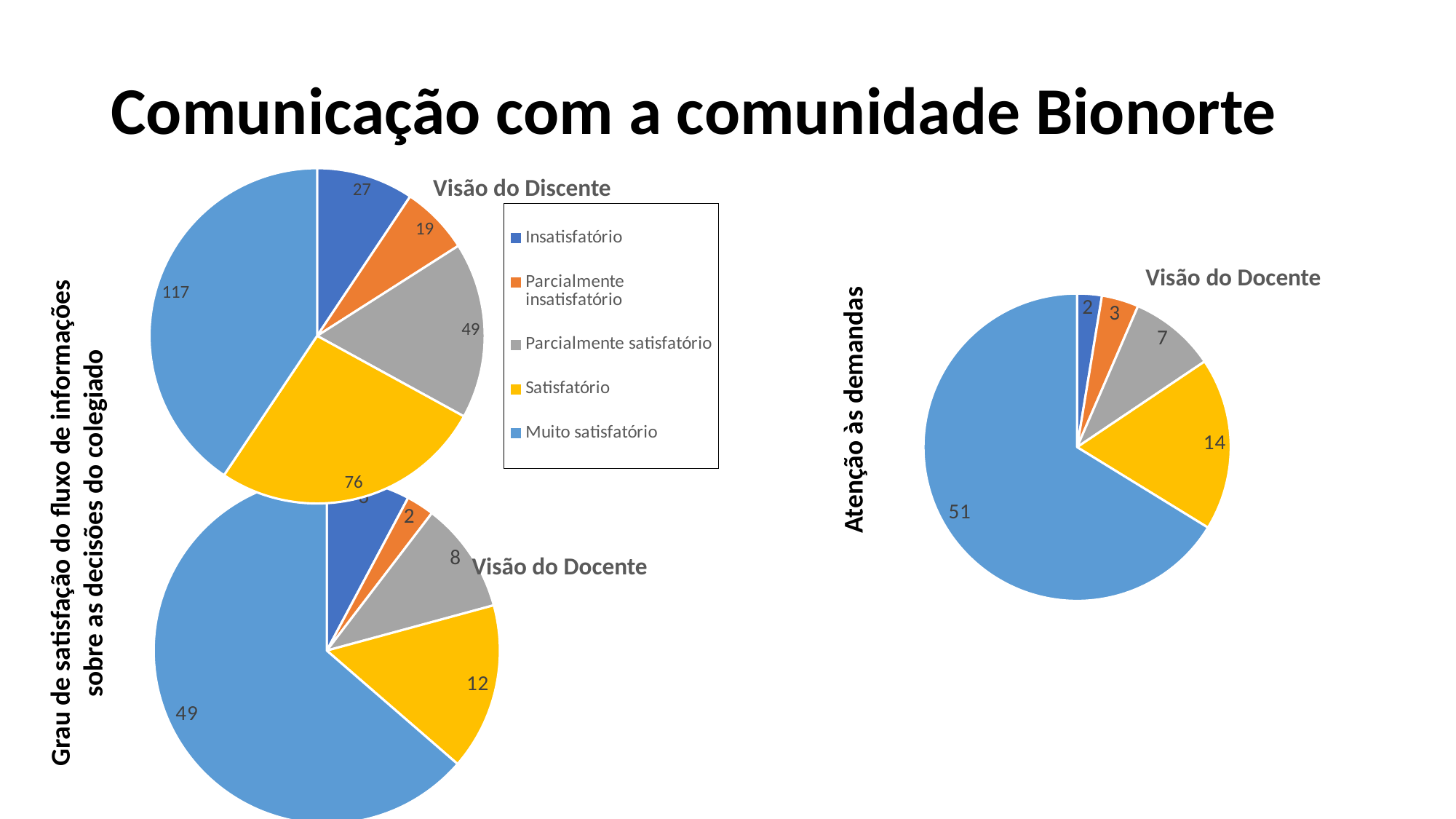
In the bottom-left pie chart titled 'Visão do Docente', which is larger, Parcialmente satisfatório or Parcialmente insatisfatório? Parcialmente satisfatório What kind of charts are shown on the slide? Pie charts In the top-left pie chart titled 'Visão do Discente', what is the value for Muito satisfatório? 117 In the right-hand pie chart titled 'Visão do Docente' (Atenção às demandas), which category has the largest slice? Muito satisfatório In the top-left pie chart titled 'Visão do Discente', which category has the smallest slice? Parcialmente insatisfatório How many entries does the legend list? 5 In the top-left pie chart titled 'Visão do Discente', what is the difference between Muito satisfatório and Satisfatório? 41 In the bottom-left pie chart titled 'Visão do Docente', what is the value for Satisfatório? 12 In the top-left pie chart titled 'Visão do Discente', what is the value for Parcialmente insatisfatório? 19 In the right-hand pie chart titled 'Visão do Docente' (Atenção às demandas), what is the difference between Parcialmente satisfatório and Parcialmente insatisfatório? 4 In the top-left pie chart titled 'Visão do Discente', how many slices does the pie have? 5 In the right-hand pie chart titled 'Visão do Docente' (Atenção às demandas), what is the value for Satisfatório? 14